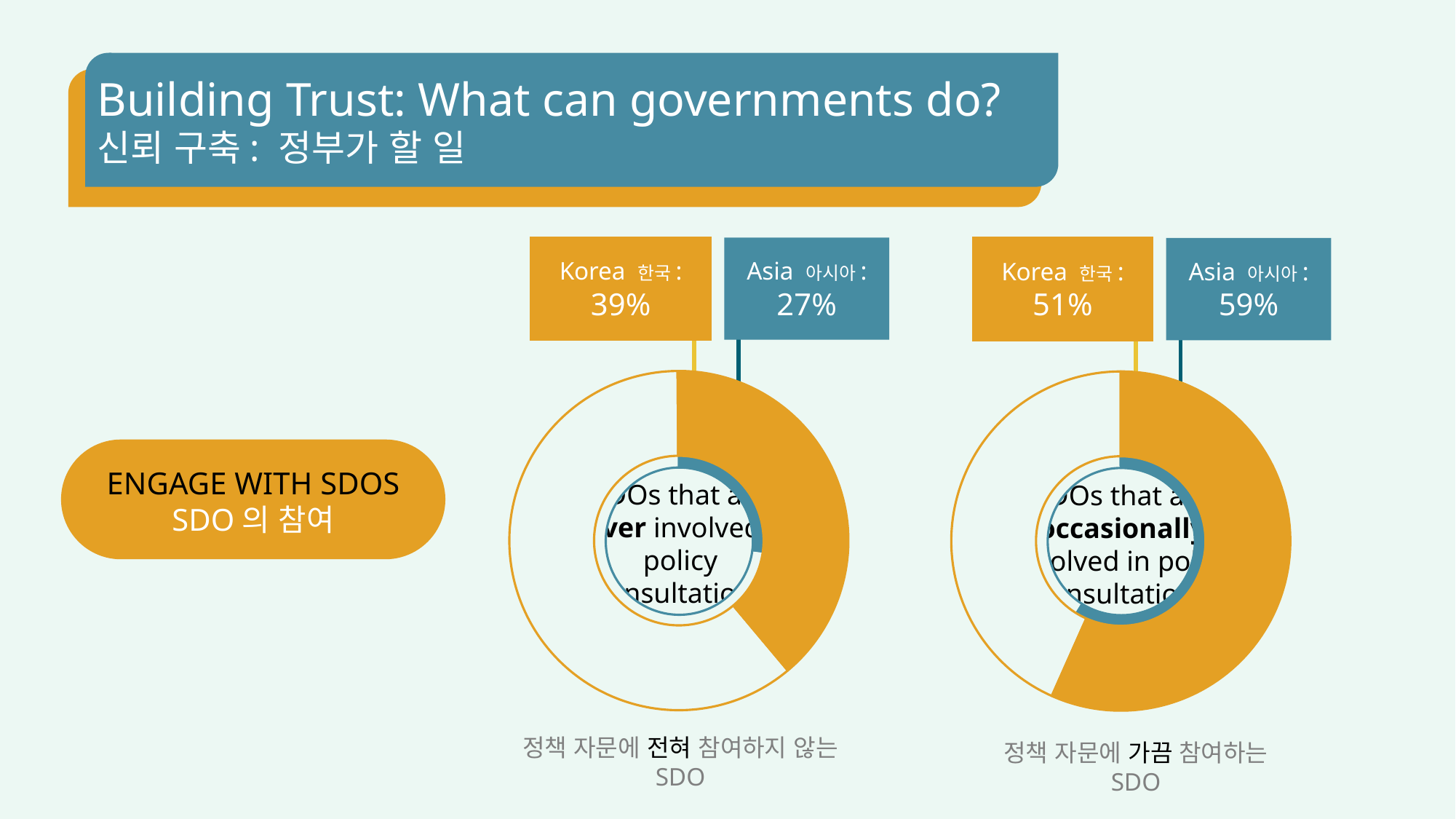
On the left chart (SDOs never involved in policy consultation), what is the difference between the Korea and Asia values? 12% Which two regions are compared in each chart on the slide? Korea and Asia On the left chart (SDOs never involved in policy consultation), what is the value for Asia? 27% On the right chart (SDOs occasionally involved in policy consultation), what is the difference between the Asia and Korea values? 8% How many charts are shown on the slide? 4 On the right chart (SDOs occasionally involved in policy consultation), what is the value for Asia? 59% On the left chart (SDOs never involved in policy consultation), which is larger, Korea or Asia? Korea What kind of chart is used on the left of the slide for SDOs never involved in policy consultation? Pie (donut) chart On the right chart (SDOs occasionally involved in policy consultation), what is the value for Korea? 51% Is the Korea value on the right chart (SDOs occasionally involved in policy consultation) greater or less than 50%? greater On the left chart (SDOs never involved in policy consultation), what is the value for Korea? 39% On the right chart (SDOs occasionally involved in policy consultation), which is larger, Korea or Asia? Asia